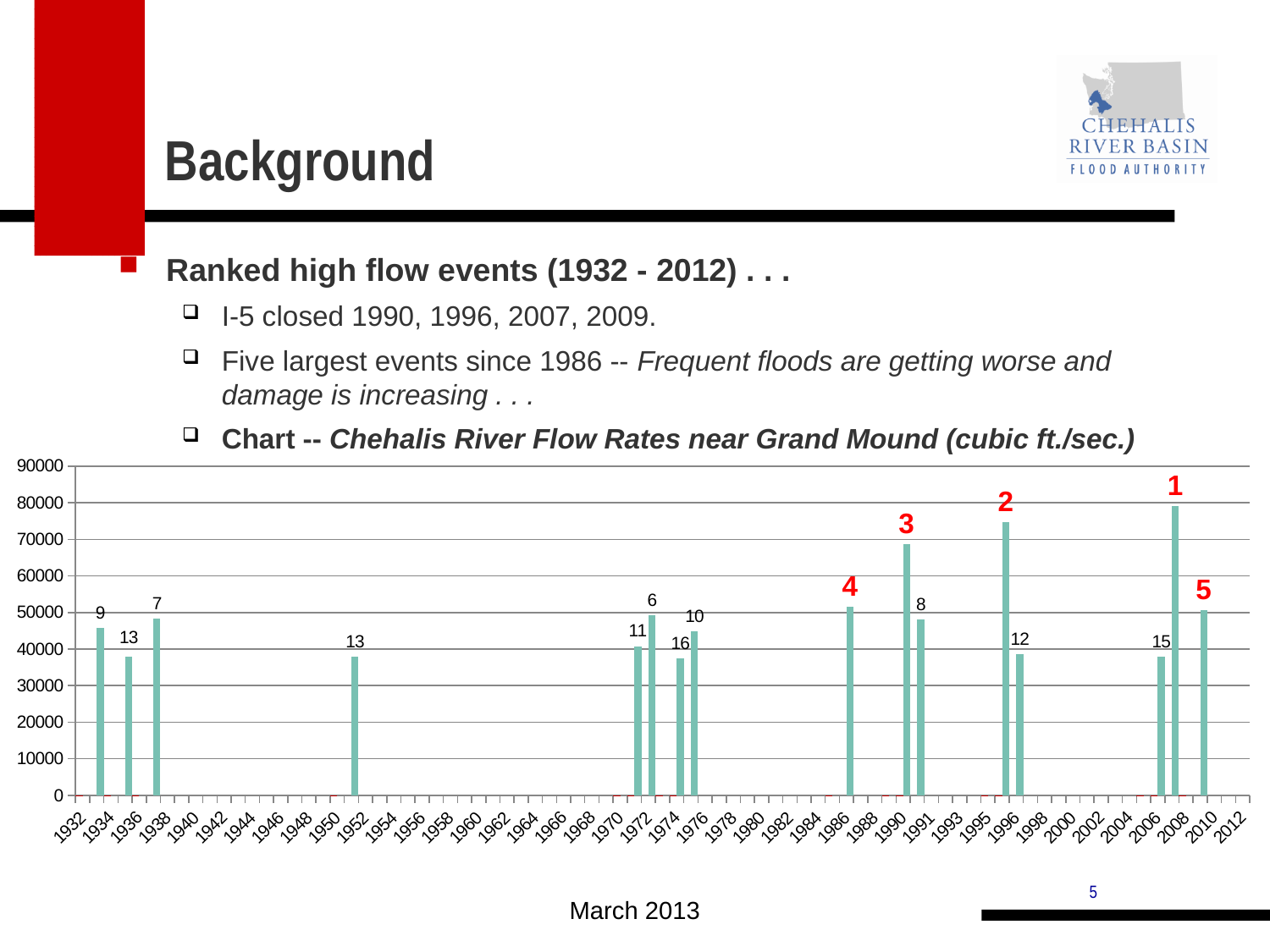
Is the value of the bar labeled 9 greater or less than 40000? greater Is the value of the bar labeled 2 greater or less than 70000? greater How many bars are plotted in the chart? 16 Is the value of the bar labeled 4 greater or less than 60000? less Which rank label is on the tallest bar in the chart? 1 What is the highest value shown on the chart's vertical axis? 90000 What kind of chart is shown on the slide? bar chart According to the slide, what does the chart show? Chehalis River Flow Rates near Grand Mound (cubic ft./sec.) Which is taller, the bar labeled 1 or the bar labeled 2? the bar labeled 1